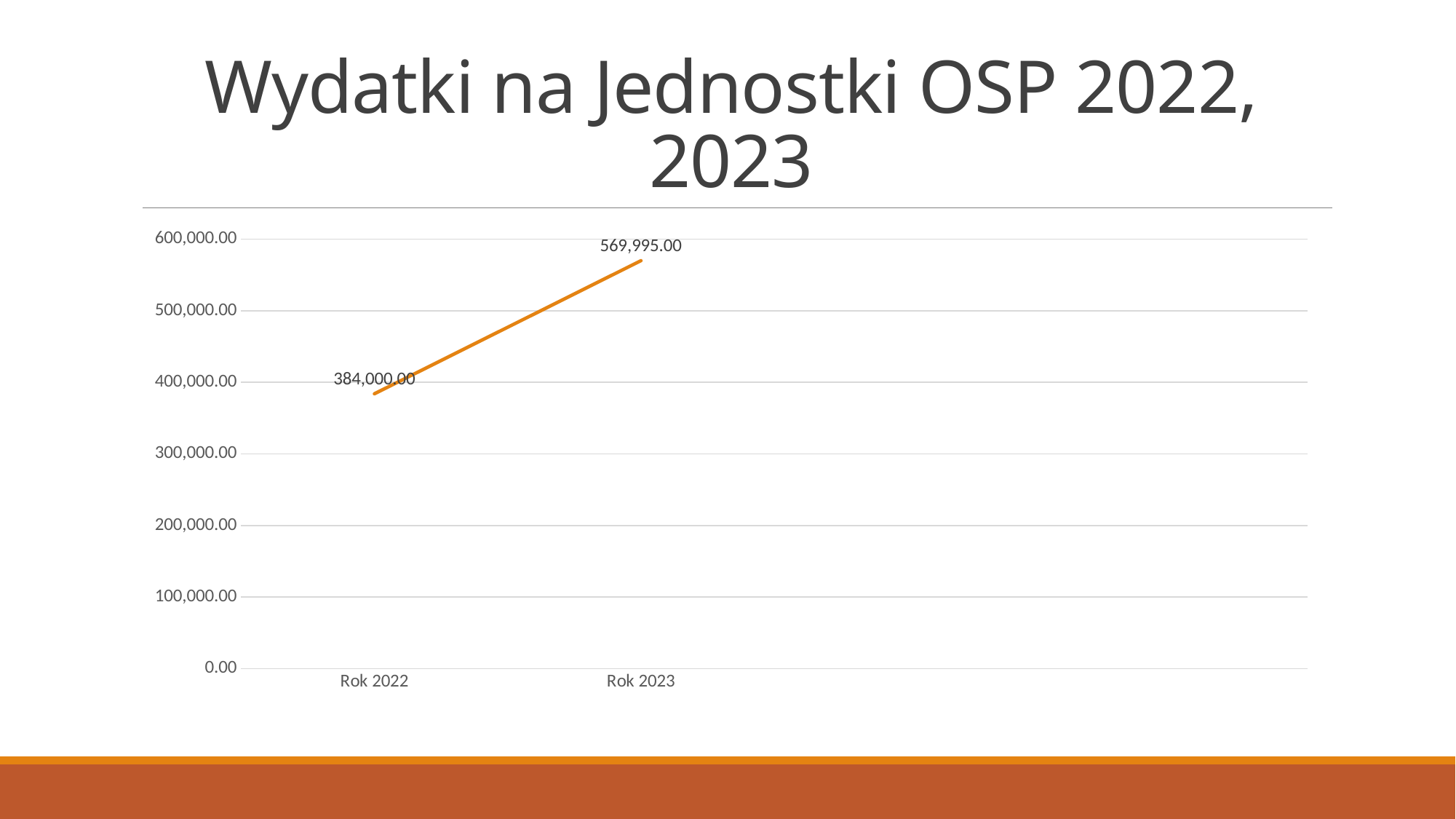
What kind of chart is shown on the slide? line chart Do the values rise or fall from Rok 2022 to Rok 2023? rise Which year has the higher value? Rok 2023 What is the title of the slide? Wydatki na Jednostki OSP 2022, 2023 Is the value for Rok 2022 greater or less than 400,000.00? less Is the value for Rok 2023 greater or less than 500,000.00? greater Is the value for Rok 2022 larger or smaller than the value for Rok 2023? smaller What is the difference between the values for Rok 2023 and Rok 2022? 185,995.00 What is the value for Rok 2022? 384,000.00 What is the value for Rok 2023? 569,995.00 How many data points are plotted on the chart? 2 Which year has the lower value? Rok 2022